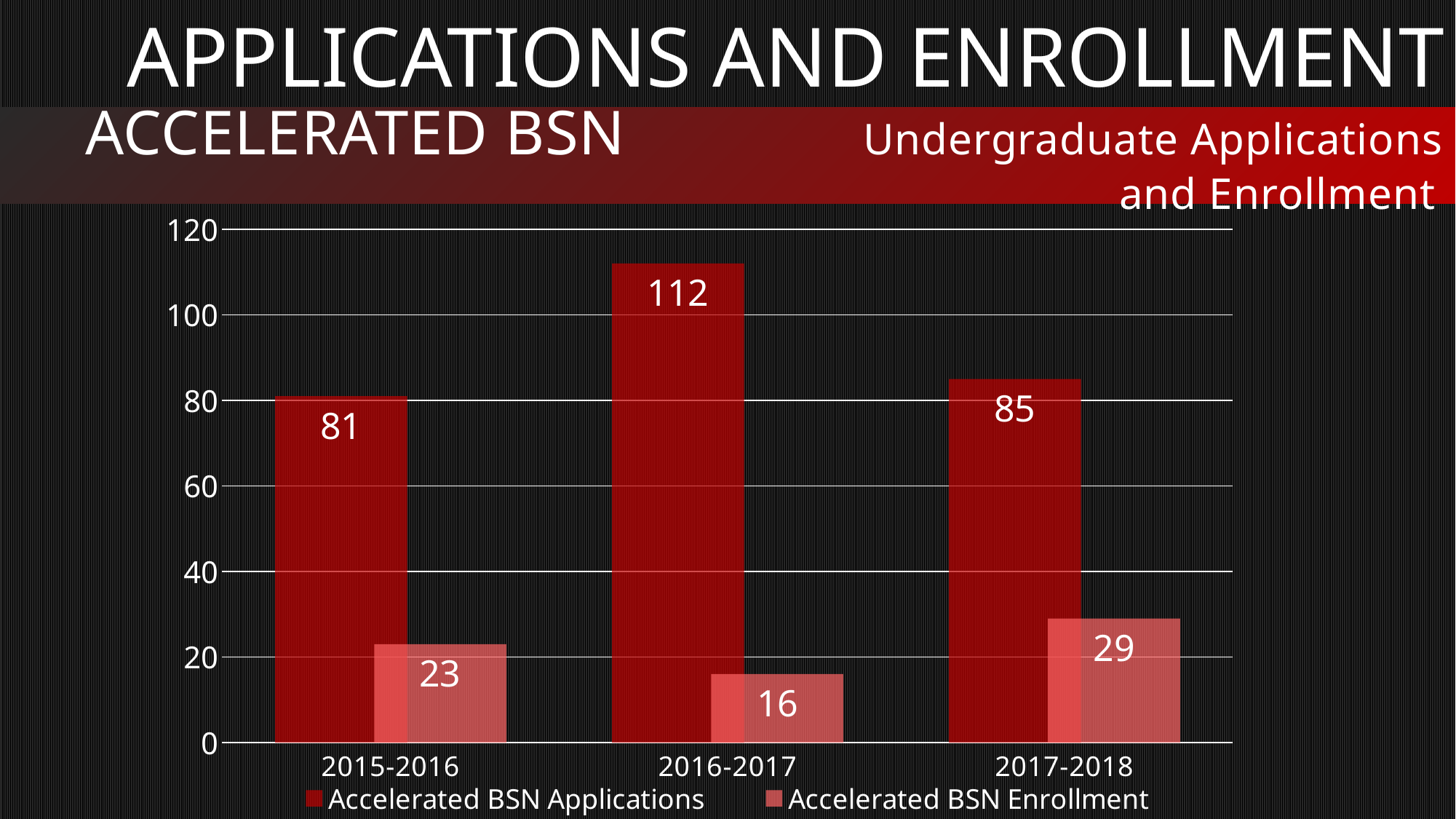
Which is larger: Accelerated BSN Applications in 2015-2016 or in 2017-2018? 2017-2018 What is the value of Accelerated BSN Enrollment for 2017-2018? 29 Which year has the highest Accelerated BSN Applications? 2016-2017 What is the difference between Accelerated BSN Applications and Accelerated BSN Enrollment in 2017-2018? 56 What is the value of Accelerated BSN Applications for 2016-2017? 112 What is the value of Accelerated BSN Enrollment for 2015-2016? 23 How many year categories are shown on the x axis? 3 Which year has the lowest Accelerated BSN Enrollment? 2016-2017 What kind of chart is shown on the slide? bar chart Is the value for Accelerated BSN Applications in 2016-2017 greater or less than 100? greater How many series does the legend list? 2